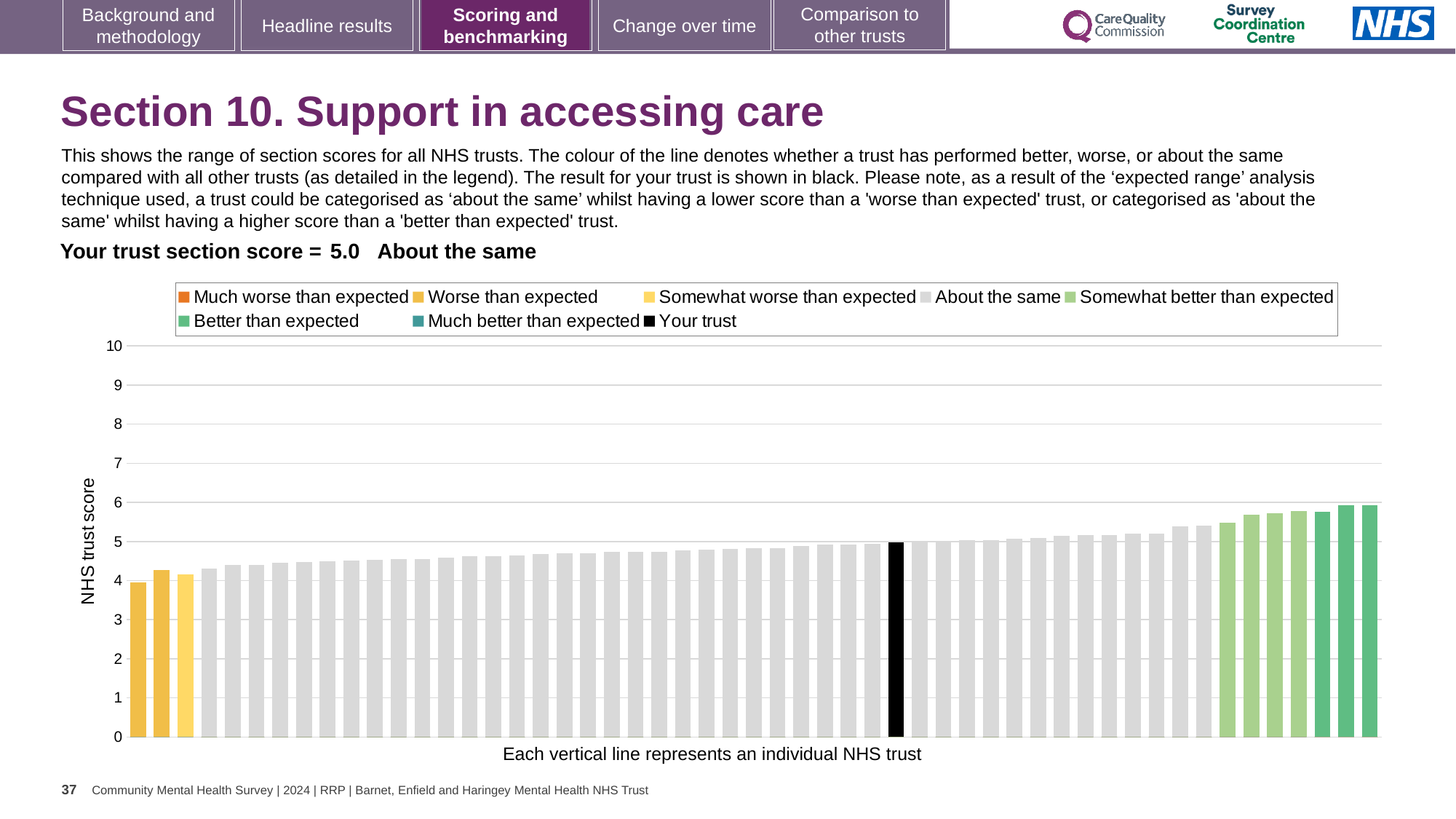
Do the bar values rise or fall from left to right across the chart? rise How many bars are coloured as 'Much better than expected' (dark green) in the chart? 0 What colour is the bar representing your trust? black Which performance category is your trust placed in for this section? About the same Is the value for your trust (the black bar) greater or less than 4? greater How many entries does the chart legend list? 8 Is the value of the highest bar in the chart greater or less than 6? less What kind of chart is shown on the slide? bar chart What is the section score for your trust shown on the slide? 5.0 Is the value of the lowest bar in the chart greater or less than 3? greater How many bars are coloured as 'Worse than expected' (yellow) in the chart? 2 What is the title of the vertical axis of the chart? NHS trust score